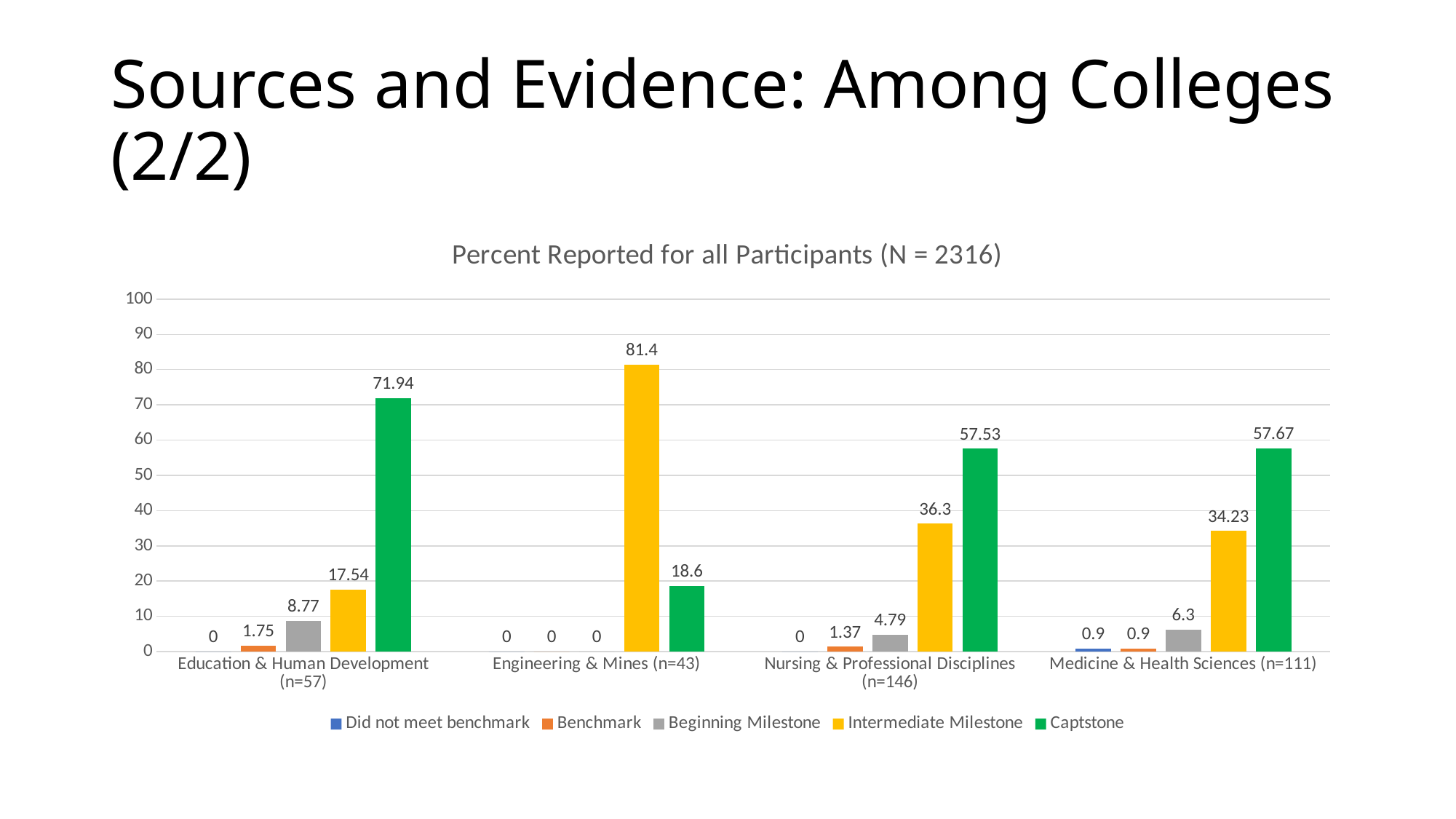
Which college has the highest Captstone value? Education & Human Development (n=57) What is the Intermediate Milestone value for Engineering & Mines (n=43)? 81.4 What is the Beginning Milestone value for Medicine & Health Sciences (n=111)? 6.3 Which is larger: the Intermediate Milestone value for Nursing & Professional Disciplines (n=146) or for Medicine & Health Sciences (n=111)? Nursing & Professional Disciplines (n=146) What is the Captstone value for Education & Human Development (n=57)? 71.94 What is the title of the chart? Percent Reported for all Participants (N = 2316) What is the Benchmark value for Nursing & Professional Disciplines (n=146)? 1.37 Which college has the lowest Intermediate Milestone value? Education & Human Development (n=57) What is the difference between the Captstone value for Education & Human Development (n=57) and the Captstone value for Engineering & Mines (n=43)? 53.34 How many colleges are shown on the x axis? 4 What kind of chart is shown on the slide? Bar chart How many series does the legend list? 5